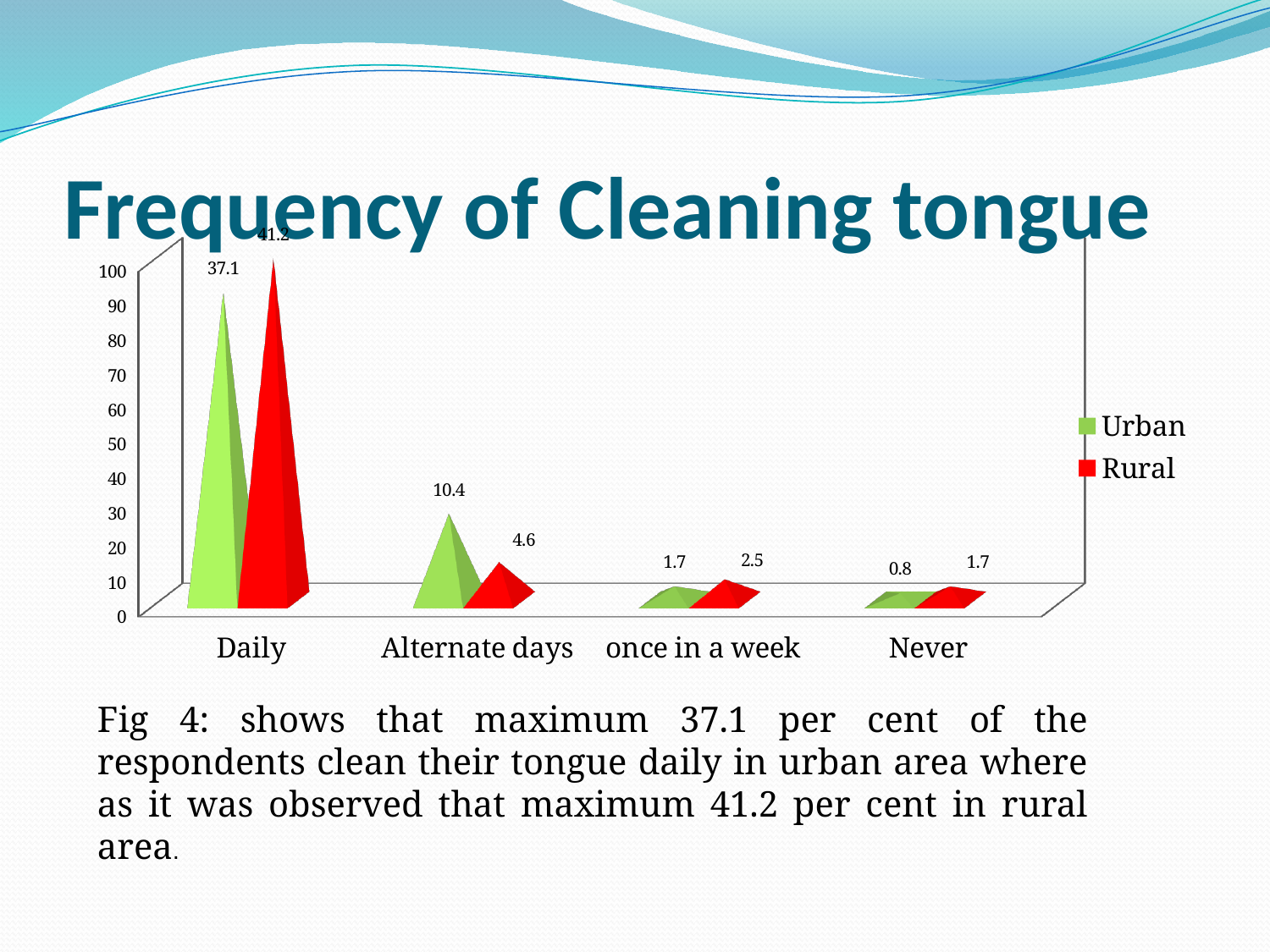
What is the Urban value for Alternate days? 10.4 Which category has the highest Rural value? Daily How many categories are shown on the x axis? 4 What is the difference between the Rural and Urban values for Daily? 4.1 How many series does the legend list? 2 What is the Urban value for Daily? 37.1 Which category has the lowest Urban value? Never What is the Urban value for Never? 0.8 What is the Rural value for once in a week? 2.5 What is the title of the chart? Frequency of Cleaning tongue What is the Rural value for Daily? 41.2 For Alternate days, which is larger, the Urban or the Rural value? Urban